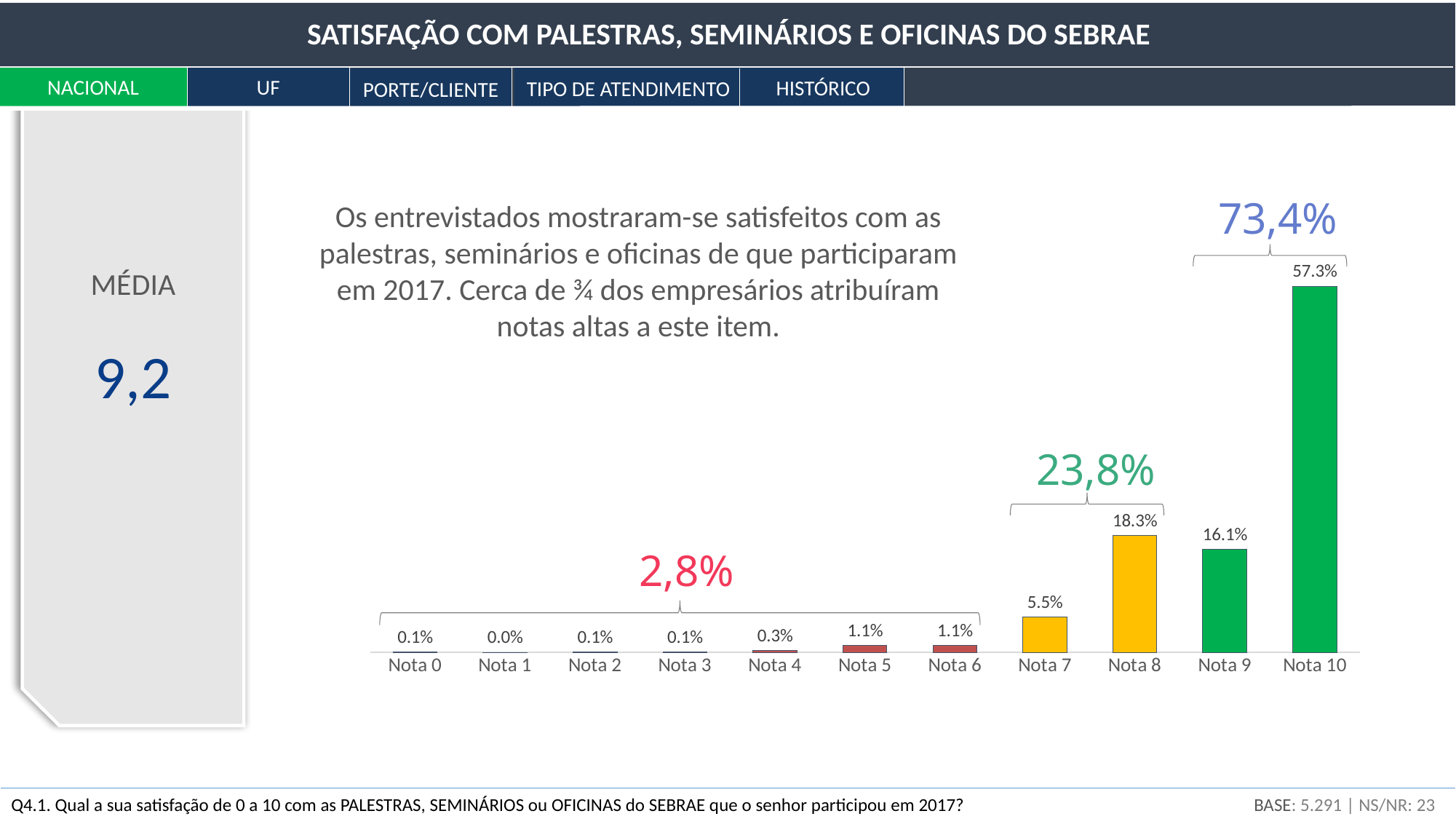
What is the value for Nota 7? 5.5% What is the value for Nota 4? 0.3% What is the difference between the values for Nota 10 and Nota 9? 41.2% How many categories are shown on the x axis? 11 What is the combined share shown above the bracket grouping Nota 9 and Nota 10? 73,4% What is the value for Nota 8? 18.3% What is the MÉDIA (average) value shown on the left of the slide? 9,2 What kind of chart is shown on the slide? bar chart Which category has the highest value? Nota 10 What is the value for Nota 10? 57.3% Which is larger, the value for Nota 8 or the value for Nota 9? Nota 8 Which category has the lowest value? Nota 1